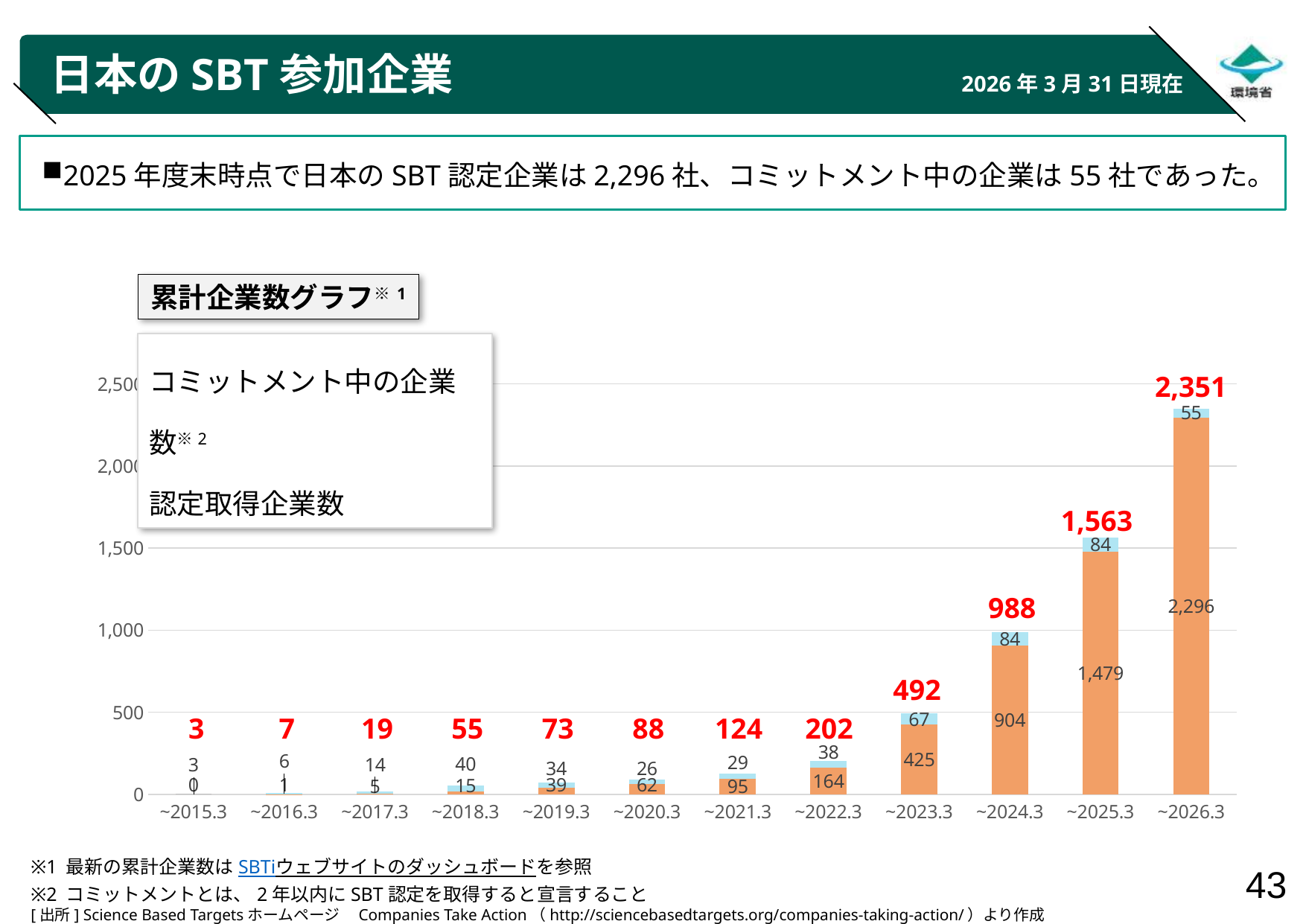
Which is larger, the 認定取得企業数 value for ~2024.3 or for ~2023.3? ~2024.3 What is the title of the chart? 累計企業数グラフ What is the difference between the totals for ~2026.3 and ~2025.3? 788 What is the value of コミットメント中の企業数 for ~2023.3? 67 How many series does the legend list? 2 What is the value of 認定取得企業数 for ~2022.3? 164 What type of chart is shown on the slide? bar chart What is the value of 認定取得企業数 for ~2025.3? 1,479 What is the total number of companies (red label) for ~2026.3? 2,351 Which category has the highest total? ~2026.3 How many categories are shown on the x axis? 12 Do the total values rise or fall from ~2015.3 to ~2026.3? rise